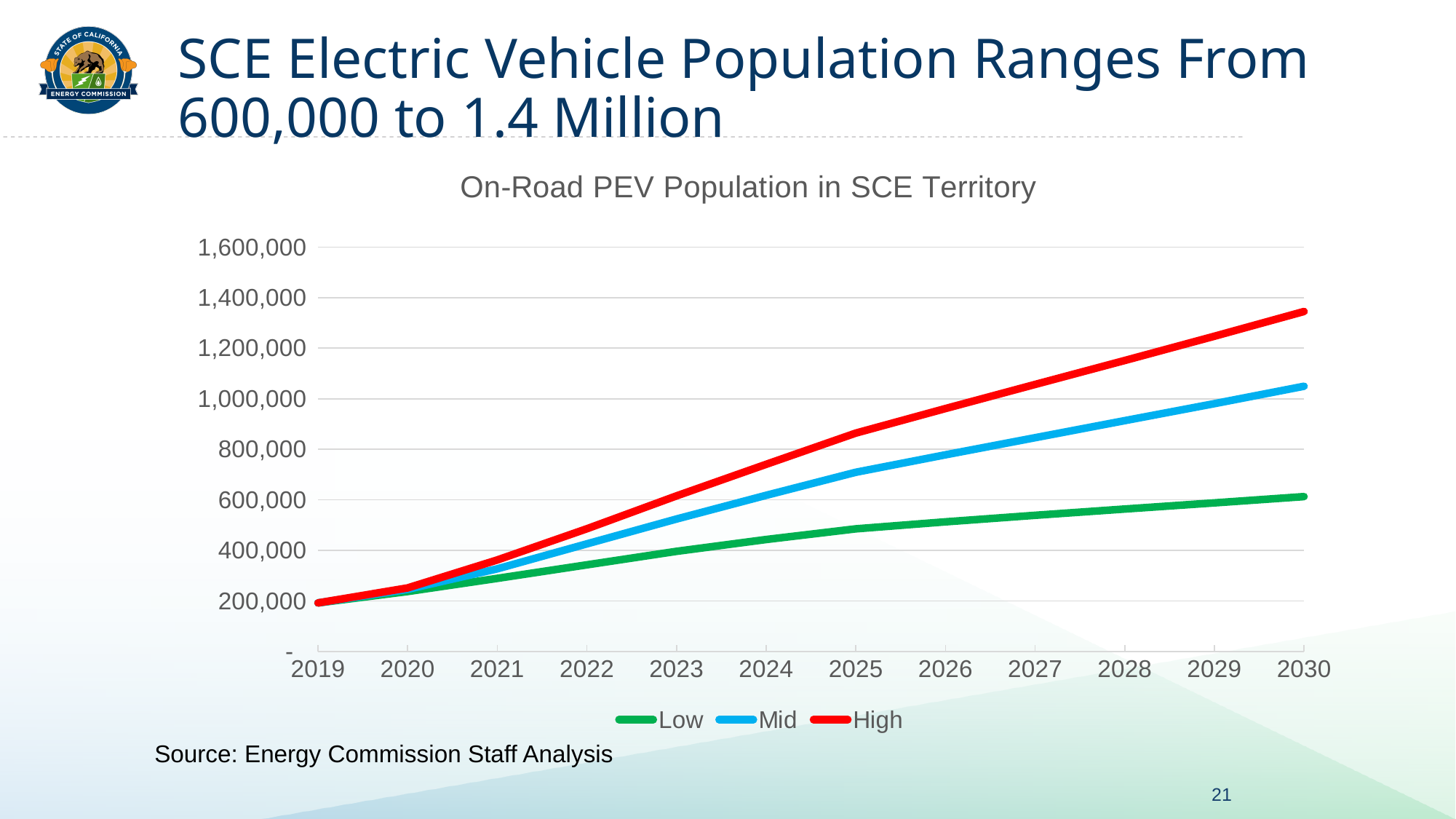
Which series has the lowest value in 2030? Low Which colour is used for the High series? red What kind of chart is shown on the slide? line chart Is the value for the High series in 2030 greater or less than 1,200,000? greater Is the value for the Low series in 2030 greater or less than 800,000? less Which series has the highest value in 2030? High What is the title of the chart? On-Road PEV Population in SCE Territory Which is larger in 2027, the Mid series or the Low series? Mid Is the value for the High series in 2025 greater or less than 800,000? greater Do the values of the Mid series rise or fall from 2019 to 2030? rise How many series does the legend list? 3 How many years are shown along the x axis? 12